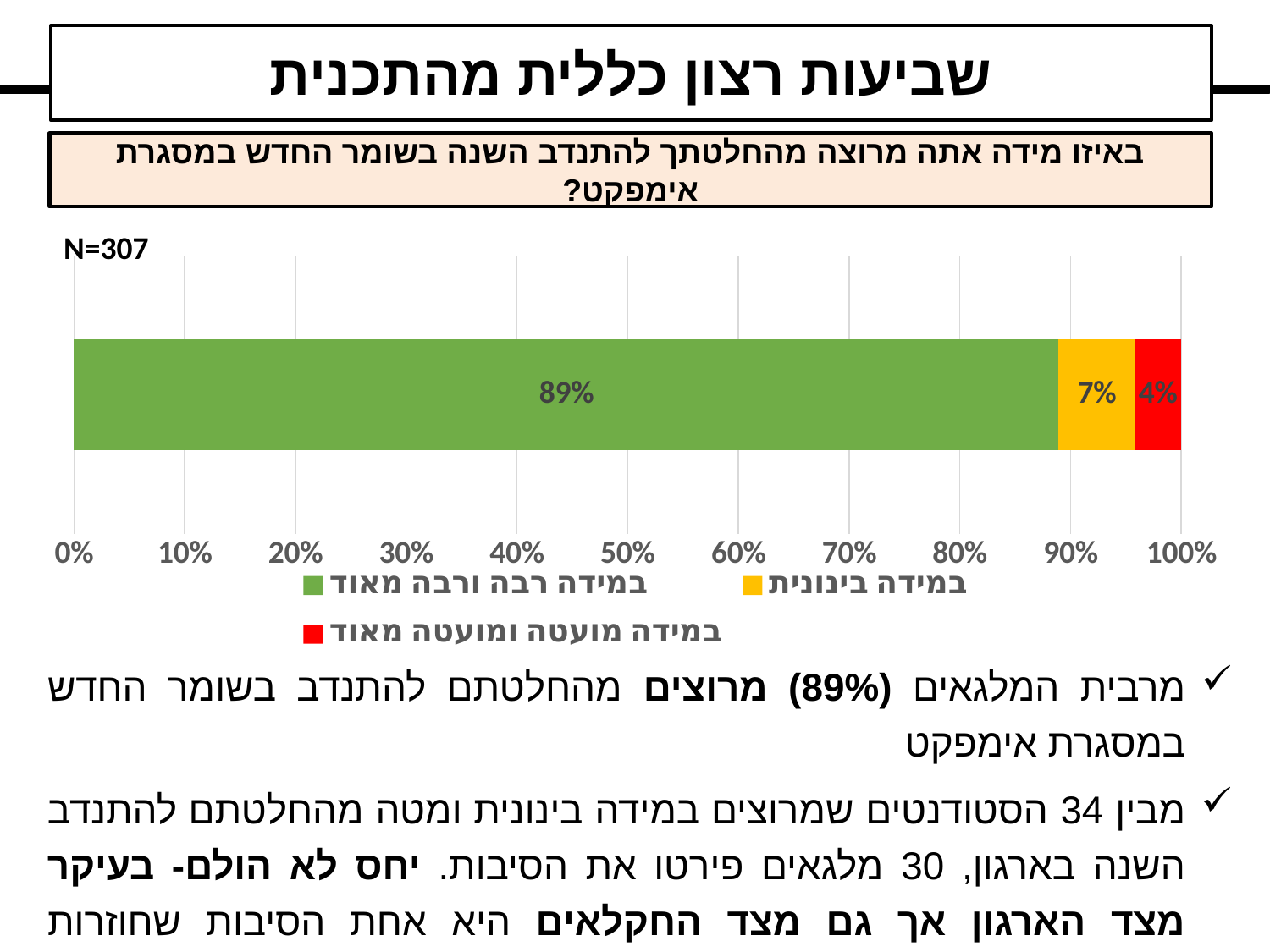
What percentage of respondents answered "במידה מועטה ומועטה מאוד"? 4% Which response category has the smallest share? במידה מועטה ומועטה מאוד What percentage of respondents answered "במידה בינונית"? 7% Which response category has the largest share? במידה רבה ורבה מאוד How many series does the legend list? 3 What kind of chart is shown on the slide? Stacked bar chart Which is larger: the share for "במידה בינונית" or the share for "במידה מועטה ומועטה מאוד"? במידה בינונית What is the sample size (N) shown above the chart? N=307 What percentage of respondents answered "במידה רבה ורבה מאוד"? 89% What is the difference in percentage points between "במידה בינונית" and "במידה מועטה ומועטה מאוד"? 3 What is the total of the three segments of the stacked bar? 100% What is the difference in percentage points between "במידה רבה ורבה מאוד" and "במידה בינונית"? 82